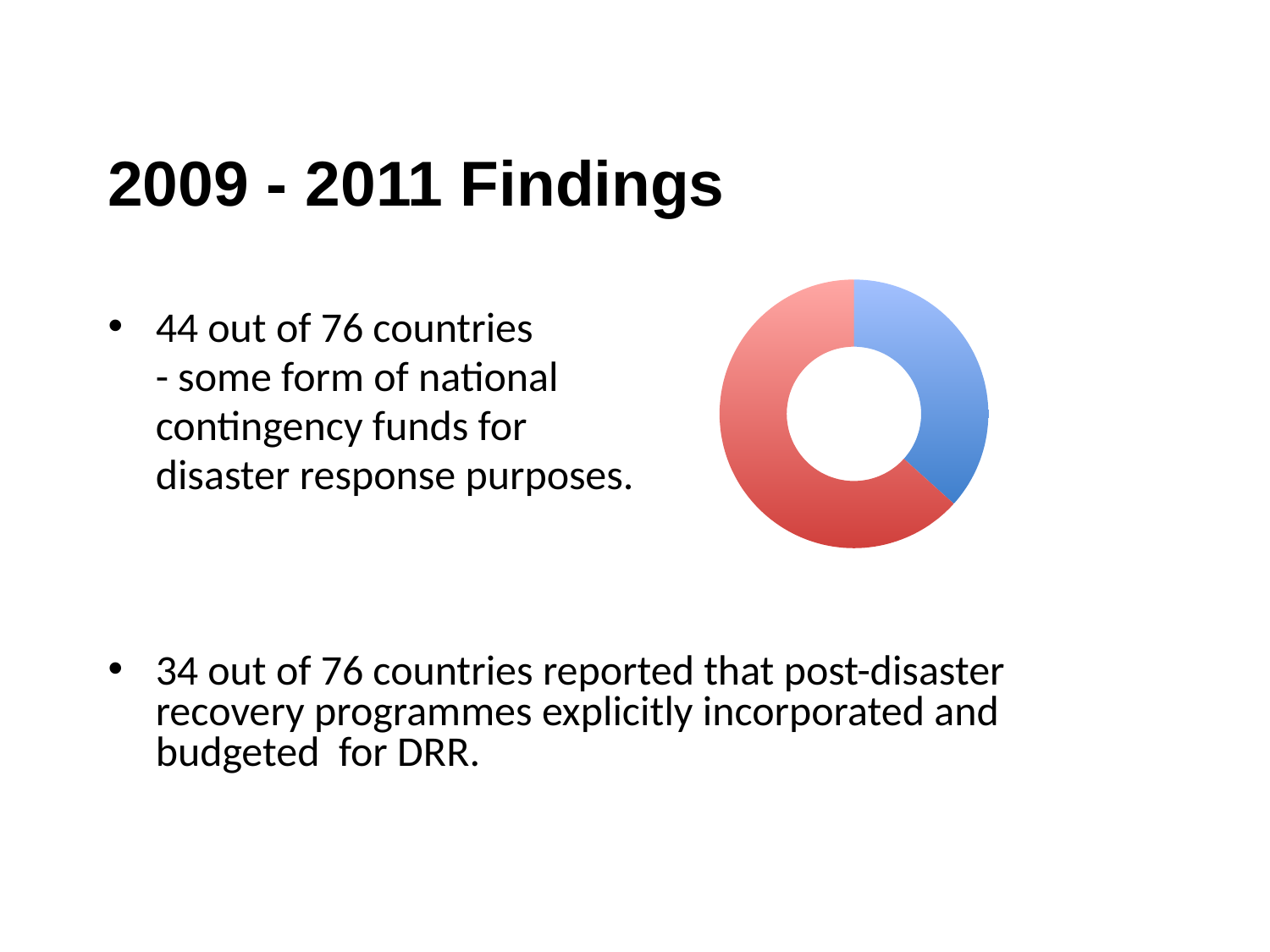
Which slice of the doughnut chart is the largest? the red slice Which slice of the doughnut chart is the smallest? the blue slice How many slices does the doughnut chart have? 2 Does the red slice cover more or less than half of the doughnut chart? more Does the doughnut chart display a legend? No Which slice is larger in the doughnut chart, the red one or the blue one? the red one What kind of chart is shown on the slide? doughnut chart What two colours are used for the slices of the doughnut chart? red and blue